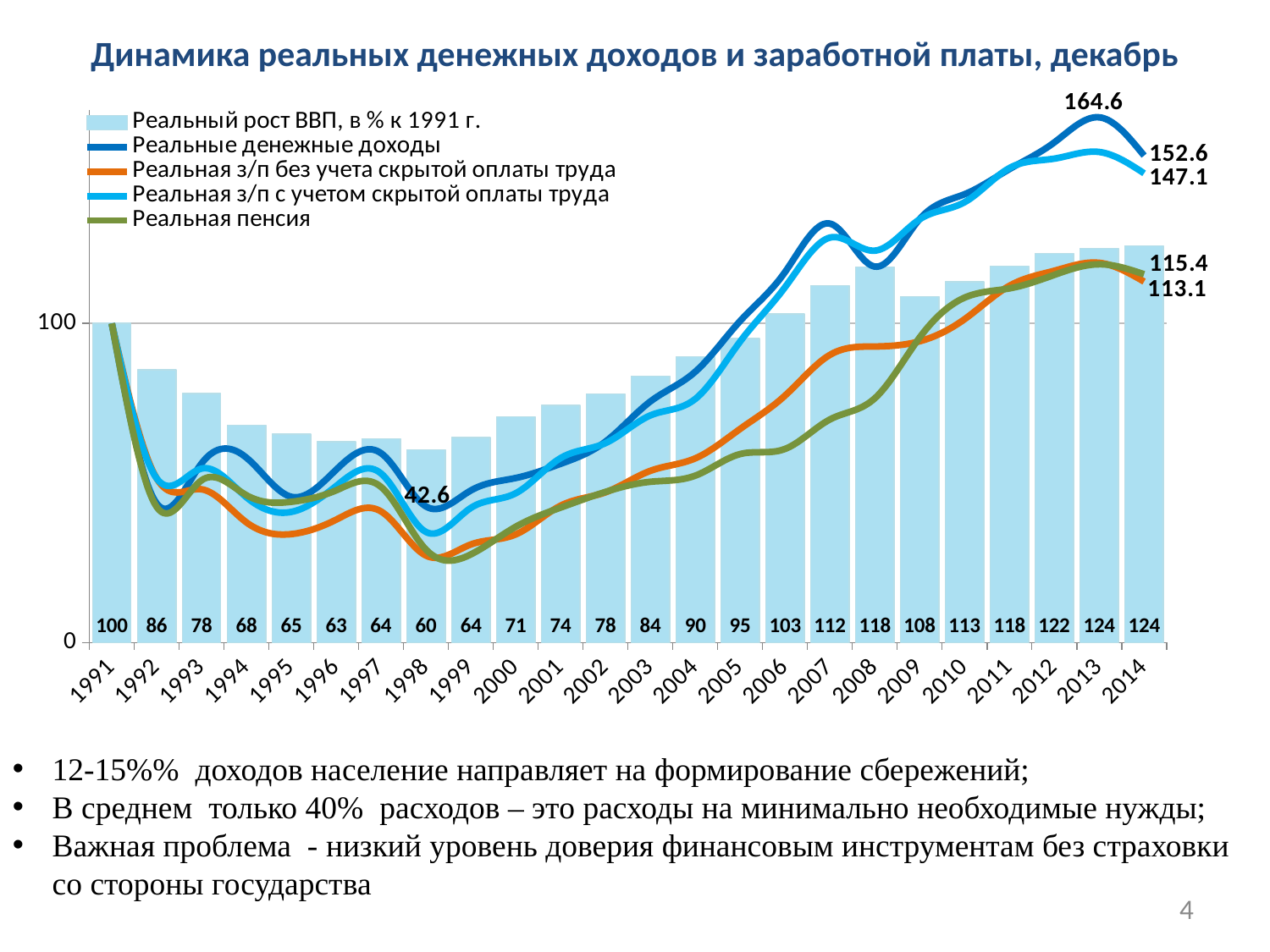
Which year has the lowest bar value? 1998 How many series does the legend list? 5 What is the value of the bar for 1998? 60 Which is larger, the bar value for 1993 or the bar value for 2003? 2003 What is the peak value labelled on the 'Реальные денежные доходы' line? 164.6 What is the value of the bar for 1991? 100 What is the 2014 value labelled for 'Реальная пенсия'? 115.4 What is the value of the bar for 2009? 108 What is the value of the bar for 2008? 118 How many years are shown on the x axis? 24 What is the difference between the bar values for 2014 and 2009? 16 Is the bar value for 2007 greater or less than 100? greater